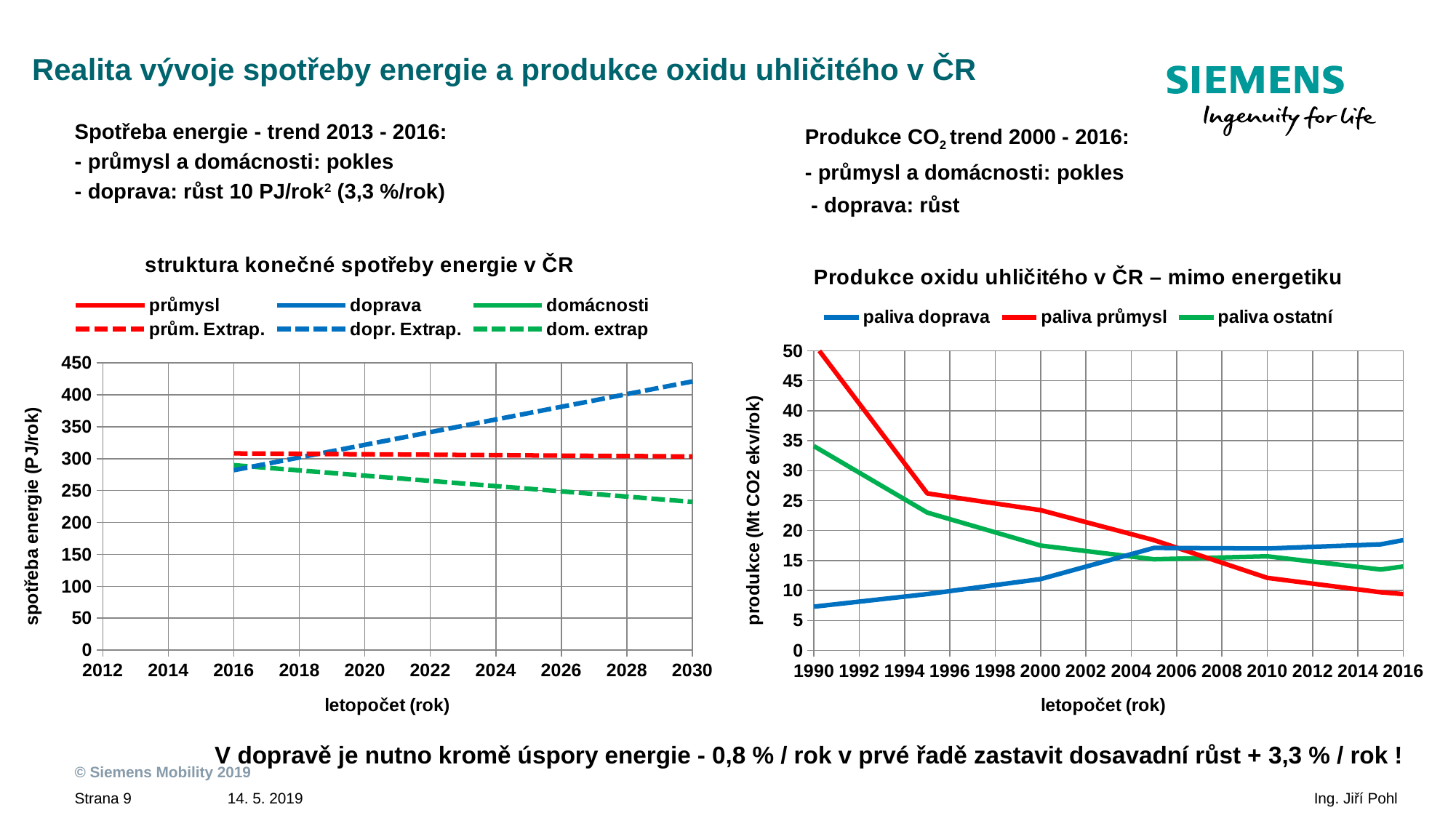
How many series does the legend of the left chart 'struktura konečné spotřeby energie v ČR' list? 6 In the left chart 'struktura konečné spotřeby energie v ČR', is the value of 'dopr. Extrap.' in 2030 greater or less than 400? greater In the right chart 'Produkce oxidu uhličitého v ČR – mimo energetiku', does the 'paliva průmysl' series rise or fall from 1990 to 2016? fall In the left chart 'struktura konečné spotřeby energie v ČR', does the 'dom. extrap' series rise or fall from 2016 to 2030? fall In the right chart 'Produkce oxidu uhličitého v ČR – mimo energetiku', does the 'paliva doprava' series rise or fall from 1990 to 2016? rise How many series does the legend of the right chart 'Produkce oxidu uhličitého v ČR – mimo energetiku' list? 3 What kind of chart is the right chart titled 'Produkce oxidu uhličitého v ČR – mimo energetiku'? line chart In the right chart 'Produkce oxidu uhličitého v ČR – mimo energetiku', is the value of 'paliva doprava' in 1990 greater or less than 10? less In the right chart 'Produkce oxidu uhličitého v ČR – mimo energetiku', which series has the highest value in 1990? paliva průmysl What kind of chart is the left chart titled 'struktura konečné spotřeby energie v ČR'? line chart In the left chart 'struktura konečné spotřeby energie v ČR', is the value of 'dom. extrap' in 2030 greater or less than 250? less